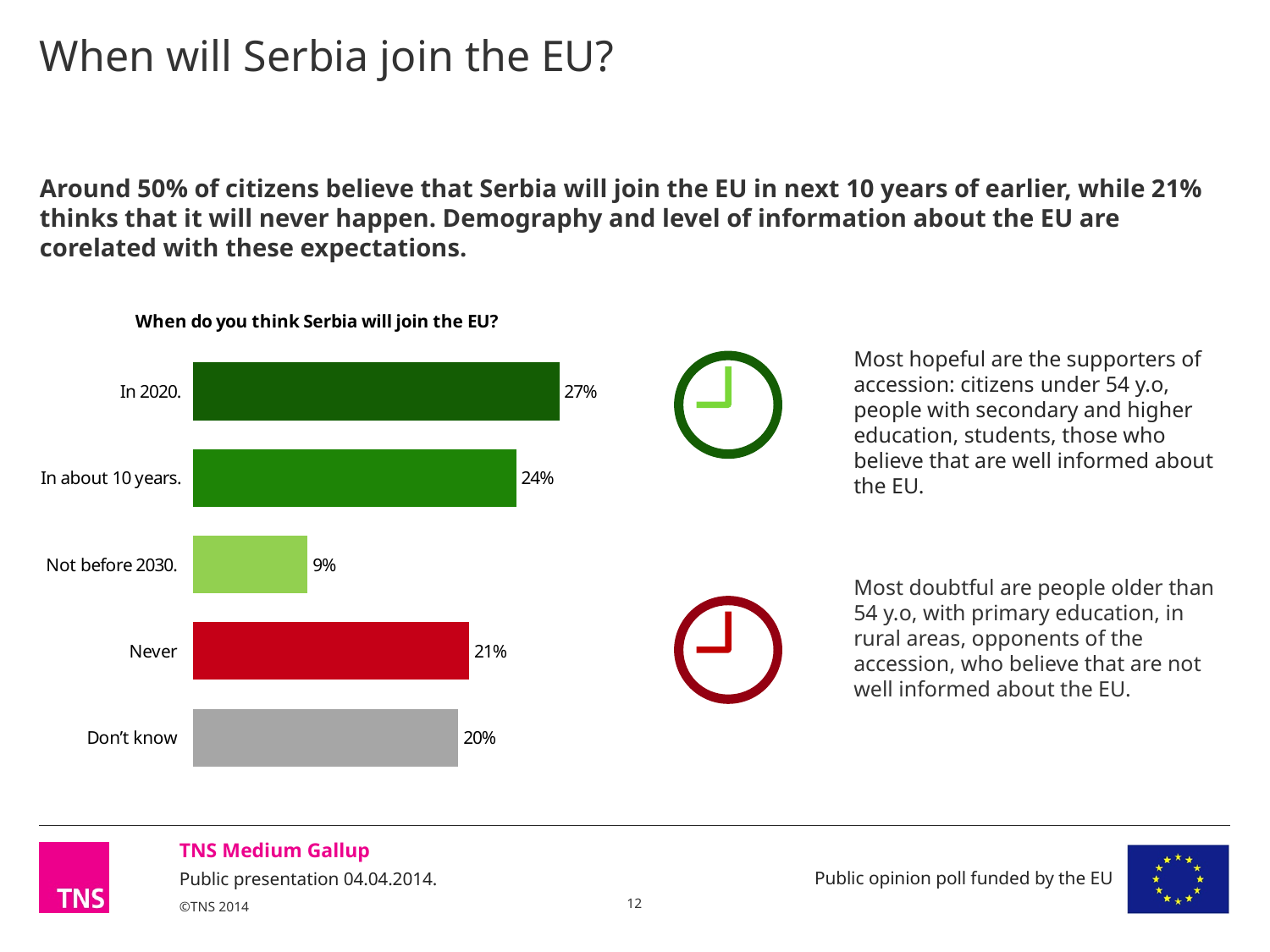
What percentage of respondents think Serbia will join the EU in 2020? 27% What percentage of respondents answered "Don't know"? 20% What percentage of respondents answered "Not before 2030"? 9% Which is larger: the percentage for "Never" or for "Don't know"? Never What percentage of respondents think Serbia will never join the EU? 21% What is the title of the chart? When do you think Serbia will join the EU? Which answer category has the highest percentage? In 2020. Which answer category has the lowest percentage? Not before 2030. What is the difference in percentage points between "In 2020" and "Never"? 6 What percentage of respondents answered "In about 10 years"? 24% How many answer categories are shown in the chart? 5 What type of chart is used to show the responses? Bar chart